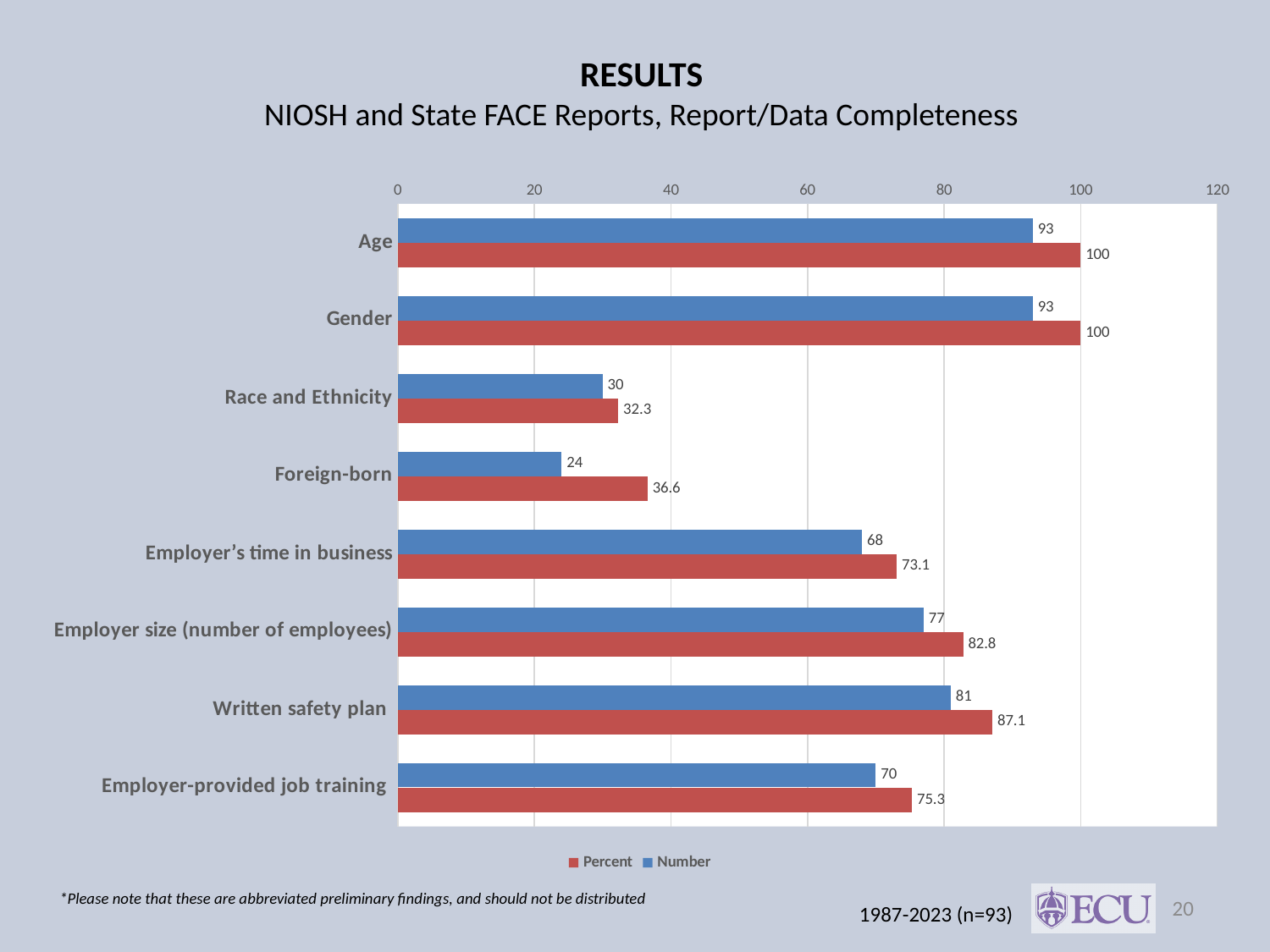
What is the Percent value for Written safety plan? 87.1 What is the Percent value for Foreign-born? 36.6 What kind of chart is shown on the slide? Bar chart What is the Number value for Race and Ethnicity? 30 Which category has the lowest Number value? Foreign-born Which is larger, the Number value for Written safety plan or the Number value for Employer size (number of employees)? Written safety plan Which category has the highest Percent value among Race and Ethnicity, Foreign-born, and Employer's time in business? Employer's time in business What is the difference between the Percent values for Employer size (number of employees) and Employer's time in business? 9.7 Which colour represents the Percent series? Red What is the Number value for Employer-provided job training? 70 How many categories are shown on the chart? 8 How many series does the legend list? 2